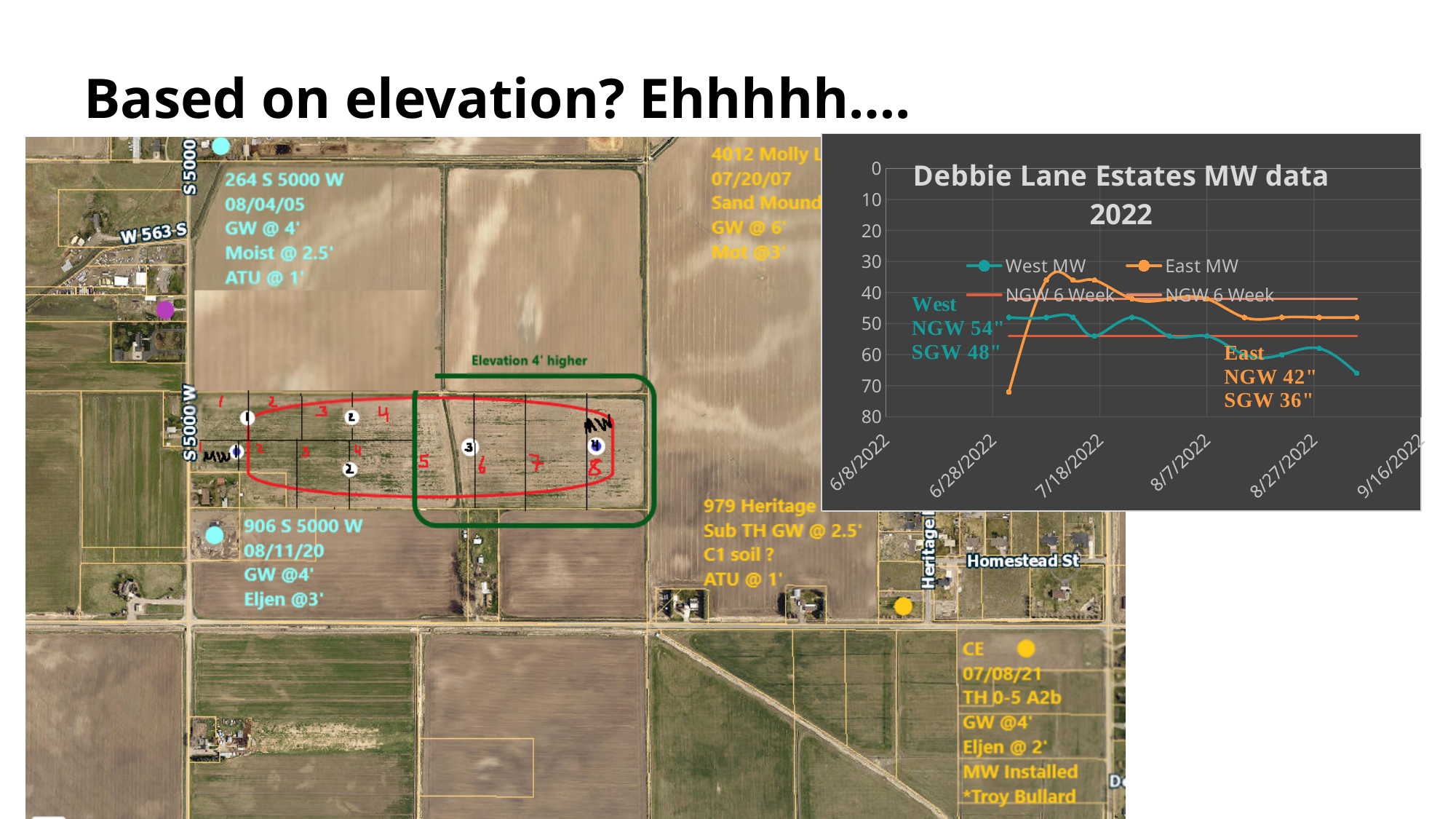
What is the title of the chart on the slide? Debbie Lane Estates MW data 2022 In the Debbie Lane Estates MW data 2022 chart, is the first West MW value greater or less than 60? less In the Debbie Lane Estates MW data 2022 chart, is the lowest East MW value (around mid-July) greater or less than 40? less In the Debbie Lane Estates MW data 2022 chart, is the last West MW value (after 8/27/2022) greater or less than 60? greater How many series does the legend of the Debbie Lane Estates MW data 2022 chart list? 4 In the Debbie Lane Estates MW data 2022 chart, does the West MW value at the end of the series (September) show a higher or lower value than at the start (late June)? higher What kind of chart is the Debbie Lane Estates MW data 2022 chart? line chart In the Debbie Lane Estates MW data 2022 chart, at 8/27/2022, which series has the larger value, West MW or East MW? West MW In the Debbie Lane Estates MW data 2022 chart, which series is drawn in orange? East MW